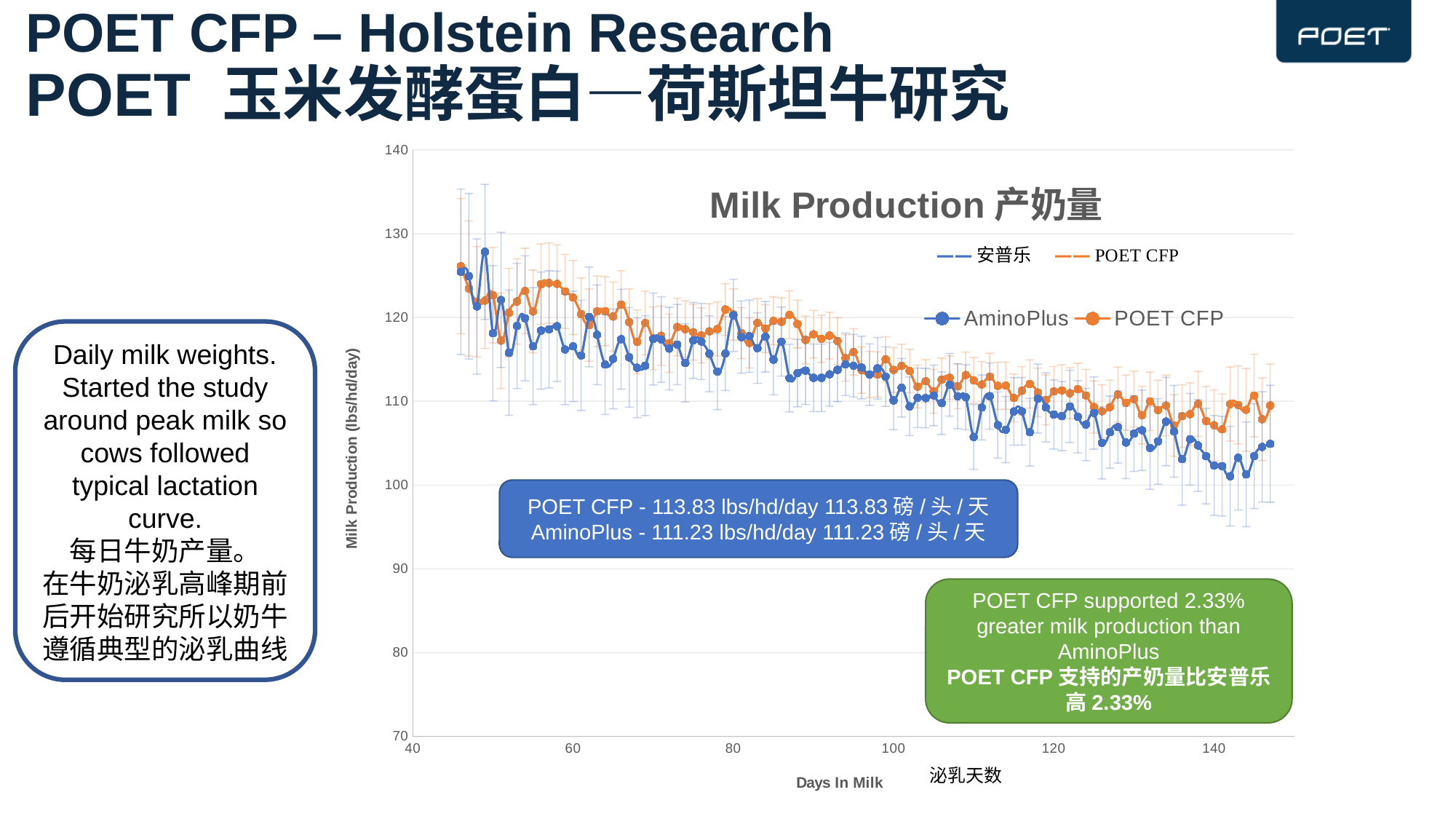
What is the difference between the POET CFP and AminoPlus milk production values given in the callout? 2.60 lbs/hd/day Which series has the higher milk production value in the callout, POET CFP or AminoPlus? POET CFP By what percentage did POET CFP support greater milk production than AminoPlus, according to the slide? 2.33% According to the callout on the chart, what is the milk production value for AminoPlus? 111.23 lbs/hd/day Is the POET CFP value at 100 Days In Milk greater or less than 110? greater What colour is the AminoPlus series plotted in? blue What is the title of the chart? Milk Production 产奶量 Do the milk production values rise or fall as Days In Milk increases? fall What kind of chart is shown on the slide? line chart At 140 Days In Milk, which series is higher, POET CFP or AminoPlus? POET CFP Is the AminoPlus value at 140 Days In Milk greater or less than 110? less According to the callout on the chart, what is the milk production value for POET CFP? 113.83 lbs/hd/day